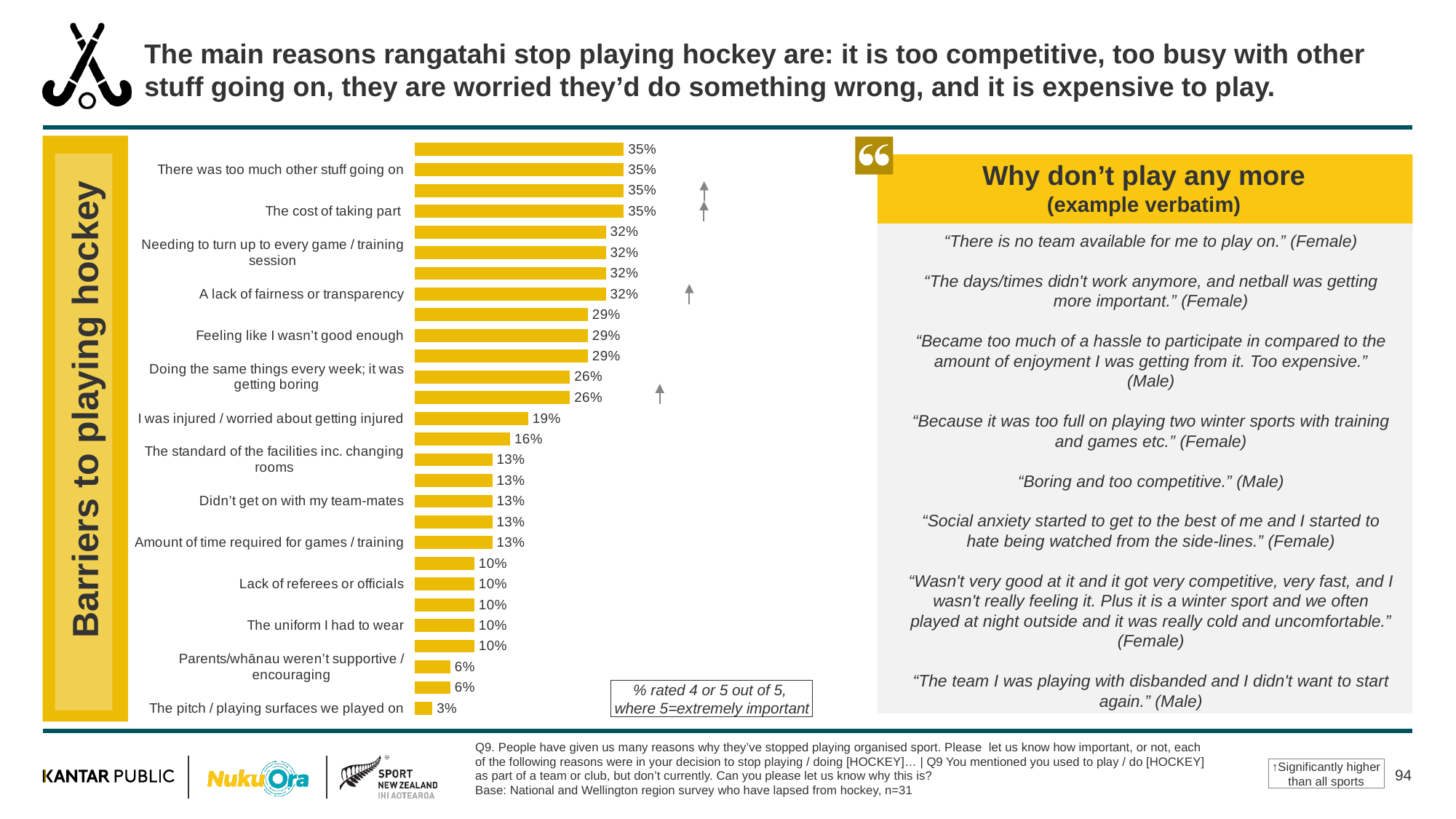
What percentage is shown for "The uniform I had to wear"? 10% What is the difference in percentage points between "There was too much other stuff going on" and "Doing the same things every week; it was getting boring"? 9 Do the bar values increase or decrease going from the top of the chart to the bottom? Decrease What percentage is shown for "The cost of taking part"? 35% What percentage is shown for "Parents/whānau weren't supportive / encouraging"? 6% What type of chart is used to show the barriers to playing hockey? Bar chart What percentage is shown for "Feeling like I wasn't good enough"? 29% According to the note on the chart, what do the percentages represent? % rated 4 or 5 out of 5, where 5=extremely important Which barrier has the lowest percentage in the chart? The pitch / playing surfaces we played on Which has a higher percentage: "A lack of fairness or transparency" or "Lack of referees or officials"? A lack of fairness or transparency How many bars are plotted in the chart? 28 What percentage is shown for "I was injured / worried about getting injured"? 19%